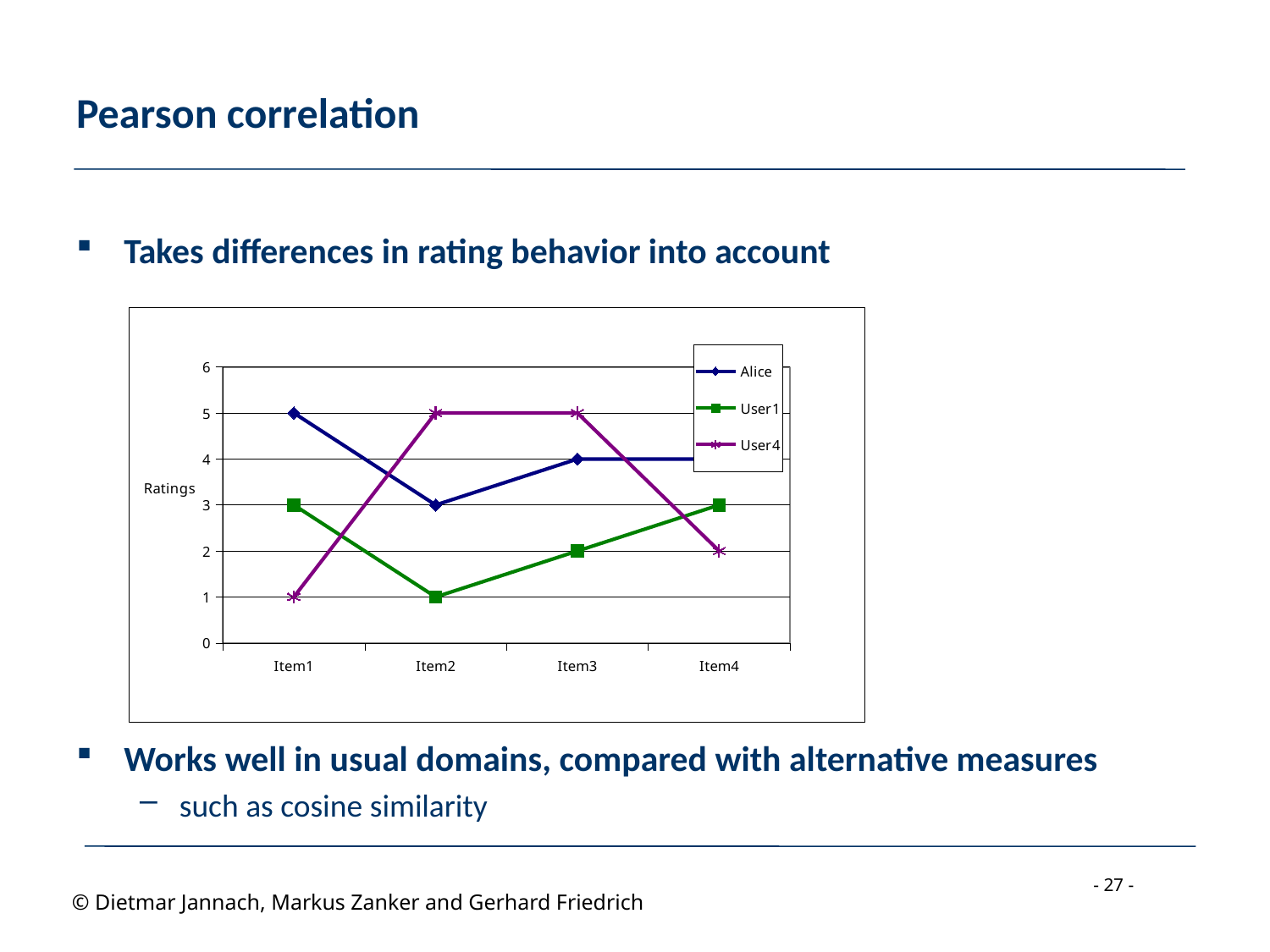
What is the label on the y axis? Ratings Do User1's ratings rise or fall from Item2 to Item4? rise For which item does User1 give the lowest rating? Item2 What is User1's rating for Item2? 1 How many series does the legend list? 3 Which is higher for Item2, Alice's rating or User4's rating? User4's rating What is User4's rating for Item4? 2 How many items are shown on the x axis? 4 What kind of chart is shown on the slide? line chart For which item does Alice give her lowest rating? Item2 What is the difference between Alice's rating and User1's rating for Item1? 2 What is Alice's rating for Item1? 5